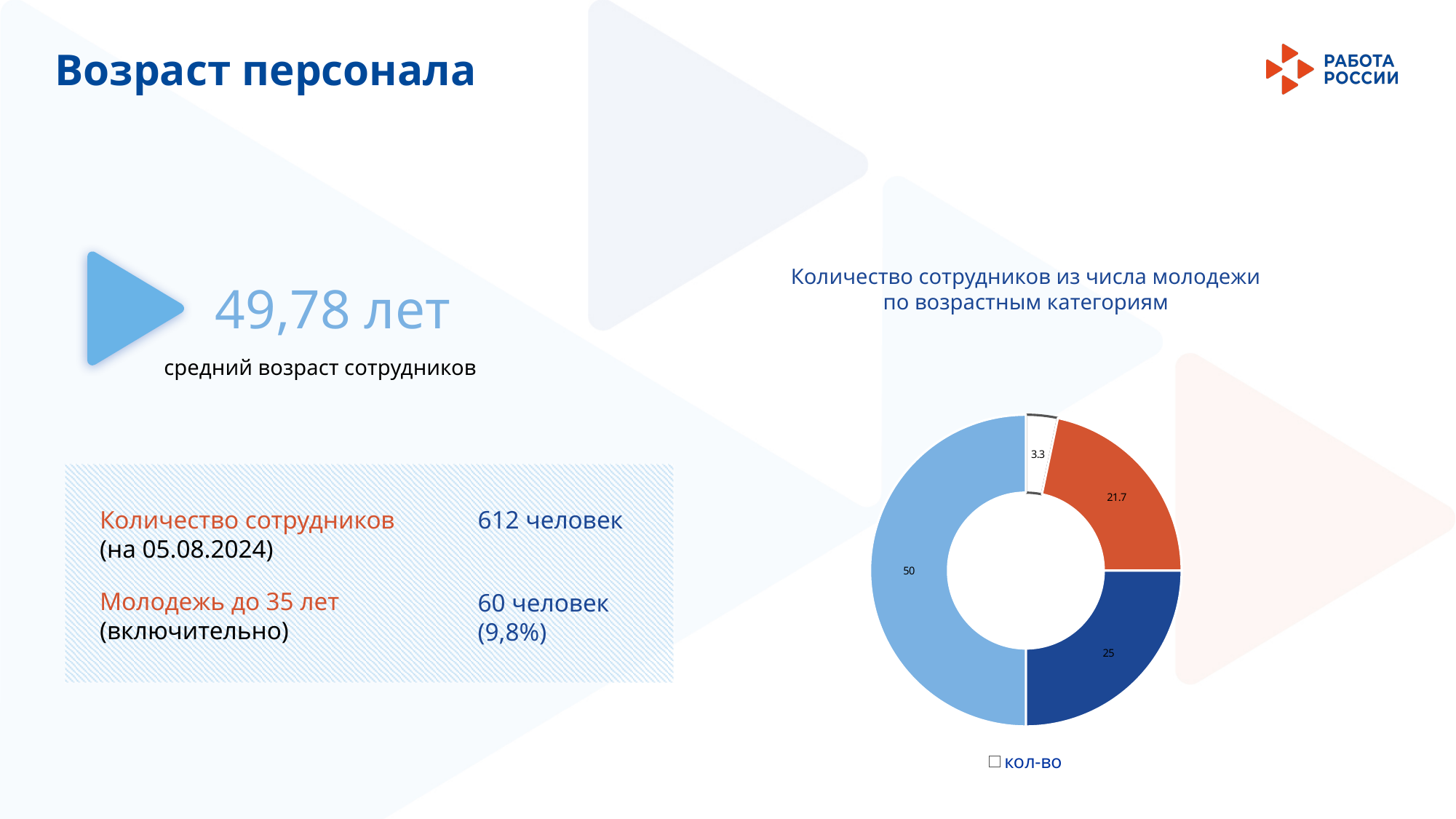
What is the smallest value shown on the donut chart? 3.3 What is the sum of all values shown on the donut chart? 100 What is the legend entry shown below the donut chart? кол-во What kind of chart is shown on the slide? Donut (pie) chart Which slice is larger: the orange slice or the dark blue slice? Dark blue (25) What is the largest value shown on the donut chart? 50 What value is labelled on the light blue slice of the donut chart? 50 What value is labelled on the dark blue slice of the donut chart? 25 How many slices does the donut chart have? 4 How many series does the chart legend list? 1 What is the difference between the largest and smallest values on the donut chart? 46.7 What value is labelled on the orange slice of the donut chart? 21.7